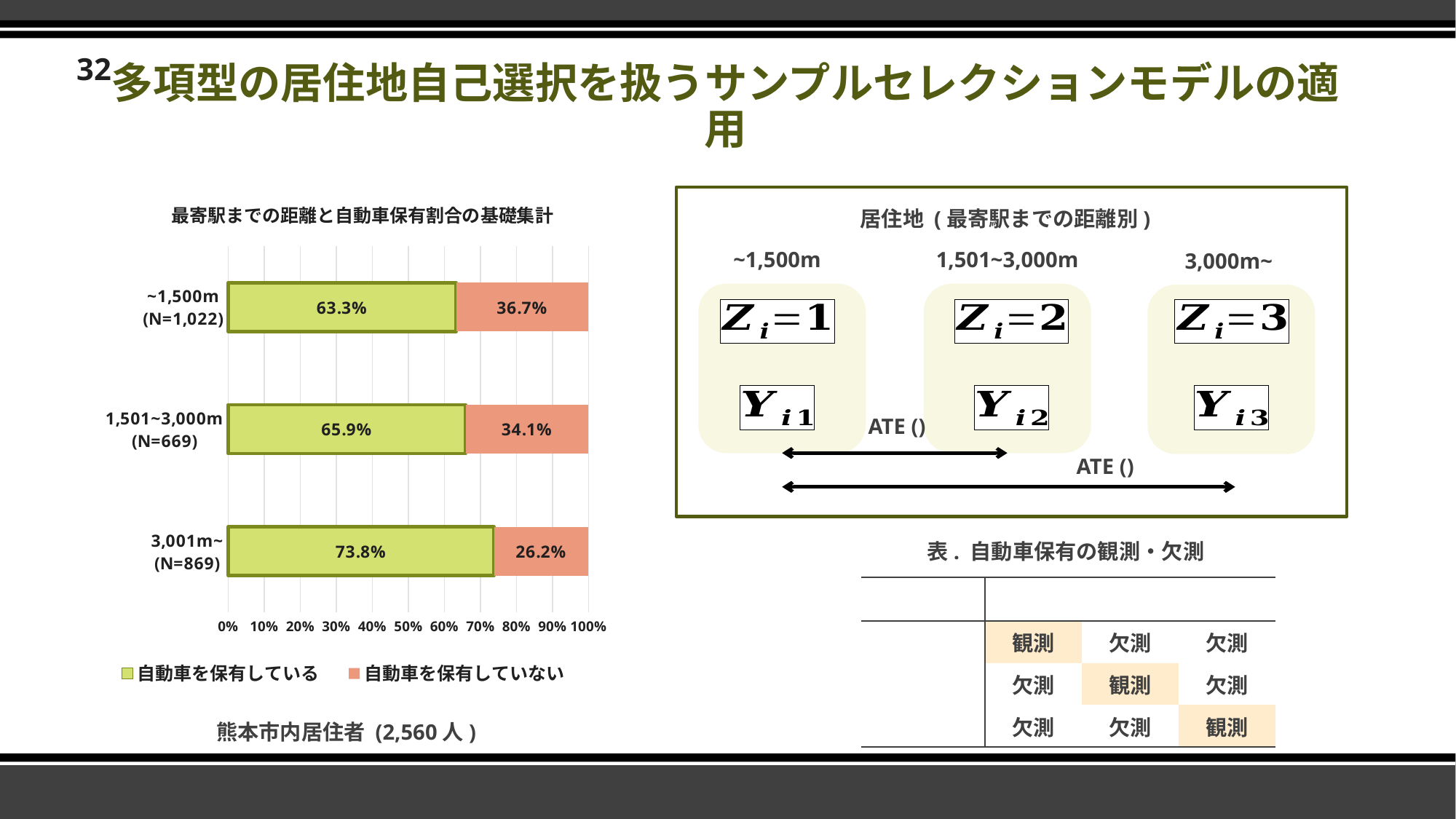
Which distance category has the lowest share of 自動車を保有していない? 3,001m~ How many distance categories are plotted in the chart? 3 What is the value of 自動車を保有している for the 3,001m~ category? 73.8% What kind of chart is shown on the slide? Stacked bar chart What is the sample size (N) shown for the 1,501~3,000m category? 669 What is the value of 自動車を保有している for the ~1,500m category? 63.3% What is the value of 自動車を保有していない for the 1,501~3,000m category? 34.1% How many series does the chart legend list? 2 Which distance category has the highest share of 自動車を保有している? 3,001m~ What is the title of the chart? 最寄駅までの距離と自動車保有割合の基礎集計 Which is larger: the 自動車を保有していない value for ~1,500m or for 3,001m~? ~1,500m What is the difference between the 自動車を保有している values for 3,001m~ and ~1,500m? 10.5%